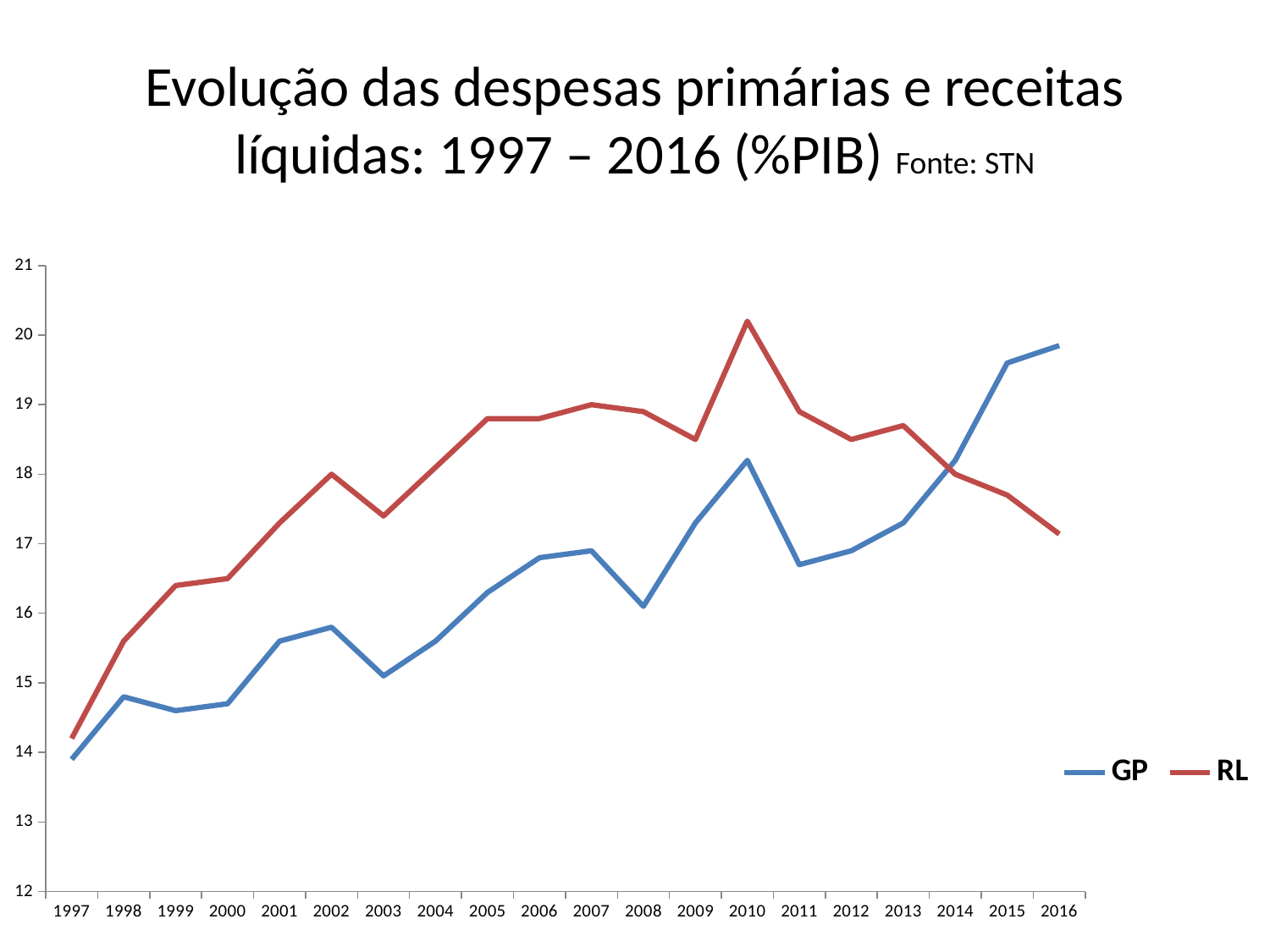
How many years are plotted along the x axis? 20 Is the value of RL in 2010 greater or less than 20? greater What kind of chart is shown on the slide? line chart What are the two entries shown in the legend? GP and RL In which year does the GP series reach its highest value? 2016 How many series does the legend list? 2 Is the value of GP in 2011 greater or less than 17? less In 2016, which series has the larger value, GP or RL? GP In which year does the RL series reach its highest value? 2010 In 2005, which series has the larger value, GP or RL? RL In which year is the GP series at its lowest value? 1997